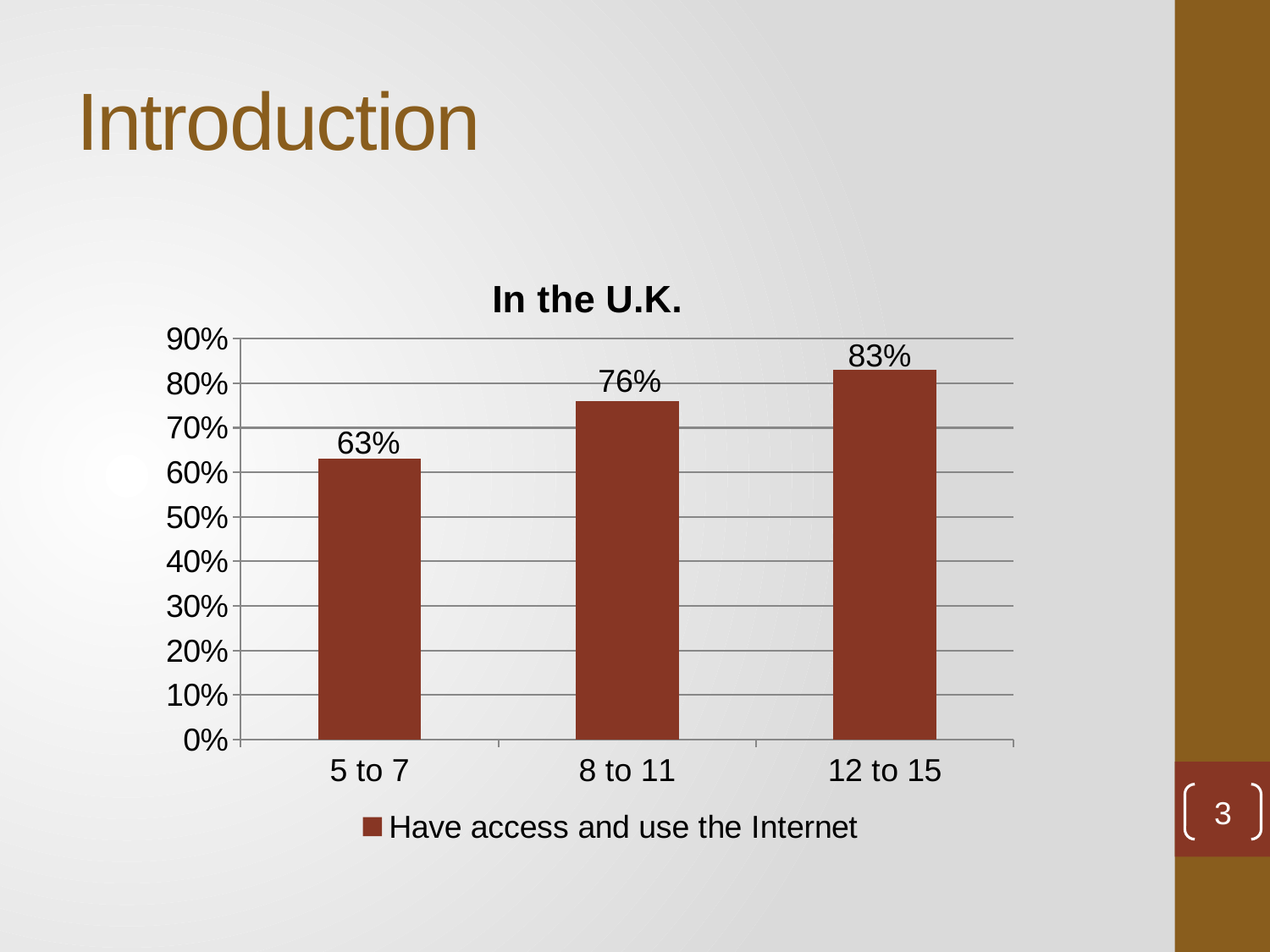
What is the value for the 8 to 11 age group? 76% Which age group has the lowest value? 5 to 7 What kind of chart is shown on the slide? Bar chart How many series does the legend list? 1 Do the values rise or fall from the 5 to 7 group to the 12 to 15 group? Rise What is the difference between the values for 12 to 15 and 5 to 7? 20% Which is larger, the value for 8 to 11 or the value for 12 to 15? 12 to 15 What is the value for the 5 to 7 age group? 63% How many age groups are shown on the chart? 3 What is the difference between the values for 8 to 11 and 5 to 7? 13% Which age group has the highest value? 12 to 15 What is the value for the 12 to 15 age group? 83%